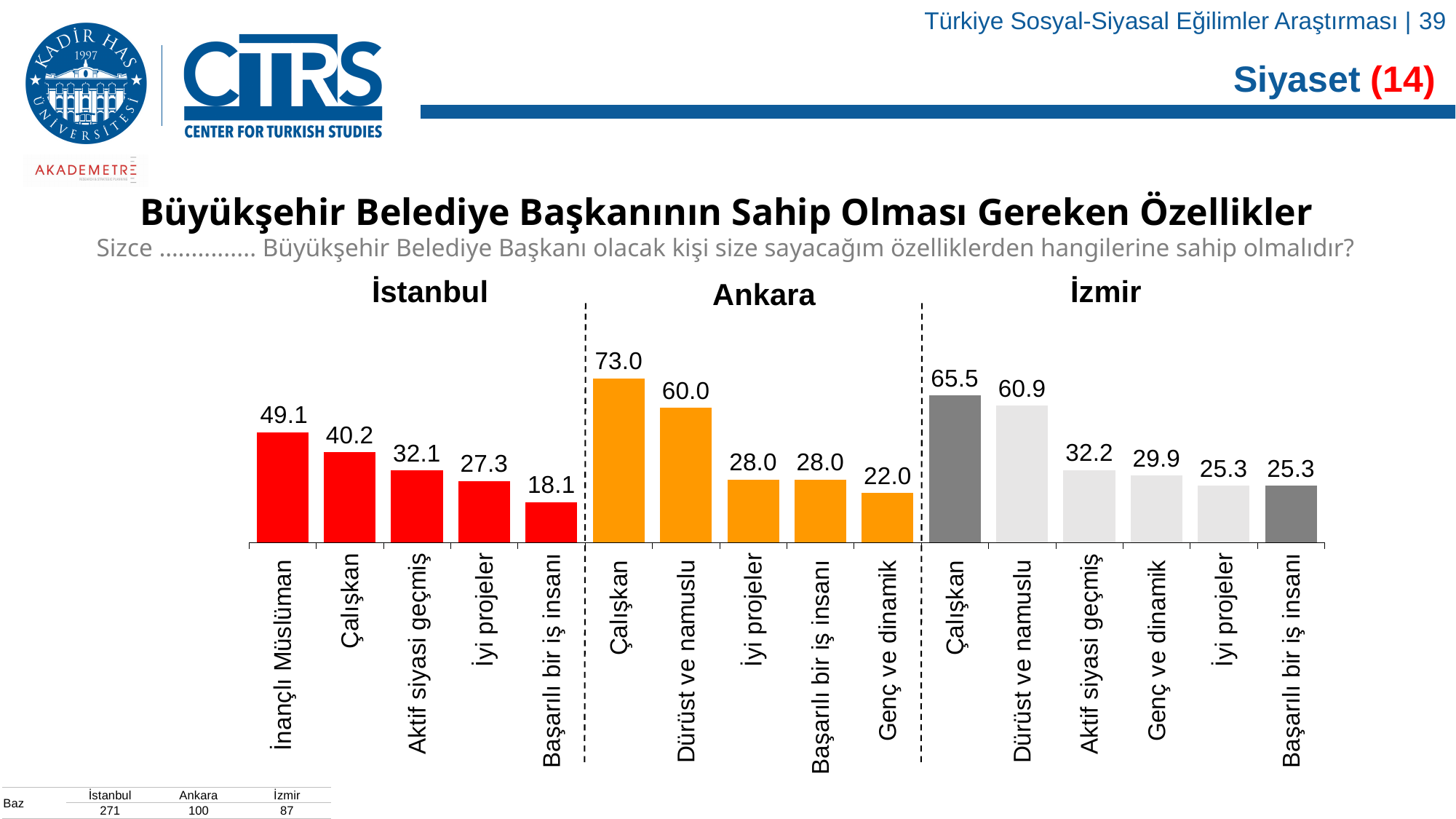
What is the value for İnançlı Müslüman in the İstanbul group? 49.1 What is the value for Dürüst ve namuslu in the Ankara group? 60.0 Which category has the highest value in the Ankara group? Çalışkan What is the difference between Çalışkan in Ankara and Çalışkan in İzmir? 7.5 Which category has the lowest value in the İstanbul group? Başarılı bir iş insanı What is the difference between İnançlı Müslüman and Çalışkan in the İstanbul group? 8.9 How many bars are shown in the chart in total across all three cities? 16 What kind of chart is shown on the slide? Bar chart Which is larger: Çalışkan in İstanbul or Aktif siyasi geçmiş in İzmir? Çalışkan in İstanbul What is the value for Genç ve dinamik in the İzmir group? 29.9 What colour are the bars in the Ankara group? Orange How many bars are shown in the İzmir group? 6